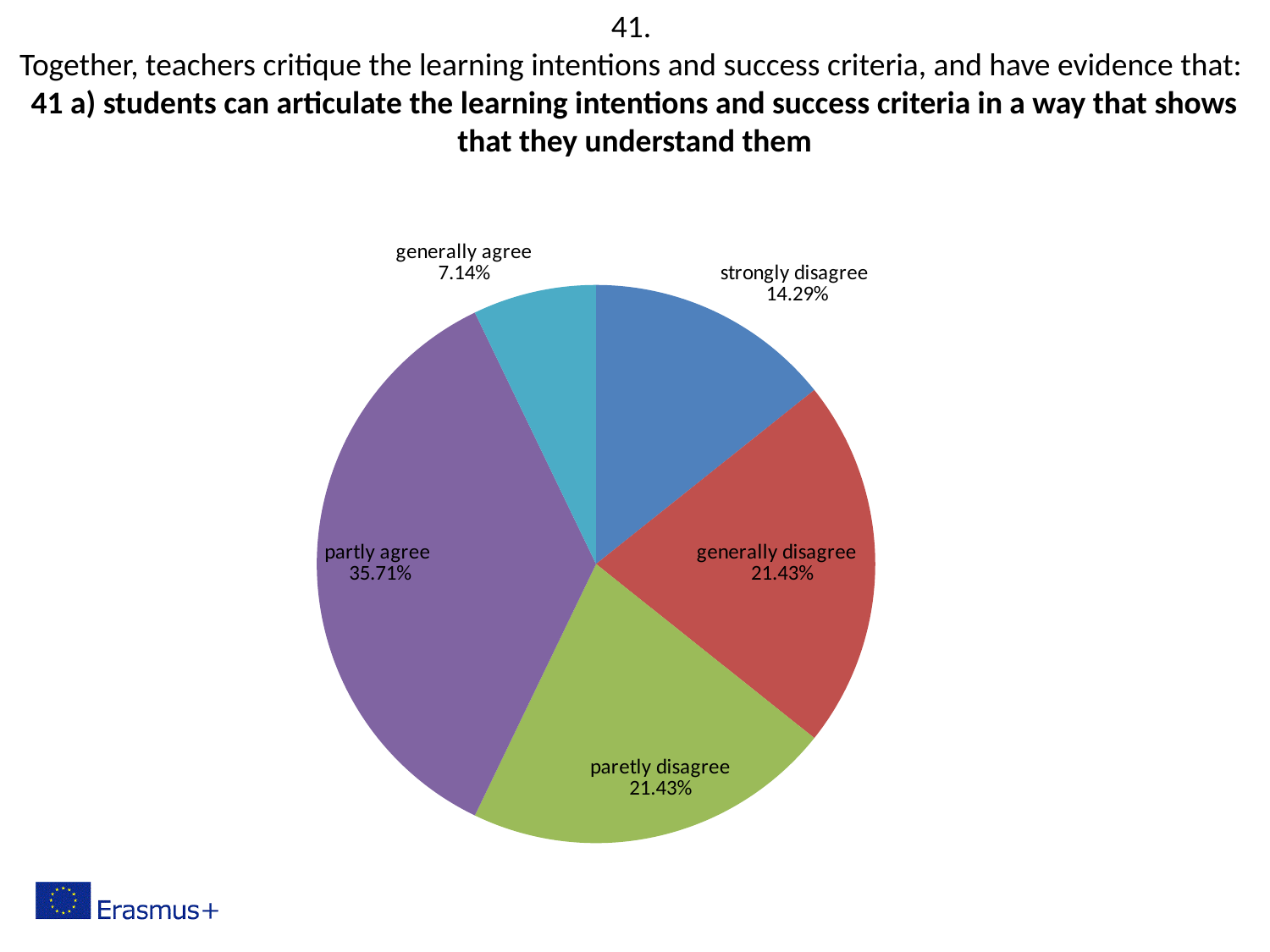
What is the difference in percentage points between "partly agree" and "strongly disagree"? 21.42 What colour is the "partly agree" slice? purple How many slices does the pie chart have? 5 What is the combined share of "generally disagree" and "paretly disagree"? 42.86% What percentage of respondents chose "strongly disagree"? 14.29% What percentage of respondents chose "generally disagree"? 21.43% Which response category has the largest share of the pie? partly agree Which response category has the smallest share of the pie? generally agree Which is larger, the share for "strongly disagree" or the share for "generally agree"? strongly disagree What percentage of respondents chose "partly agree"? 35.71% What percentage of respondents chose "generally agree"? 7.14% What kind of chart is shown on the slide? pie chart